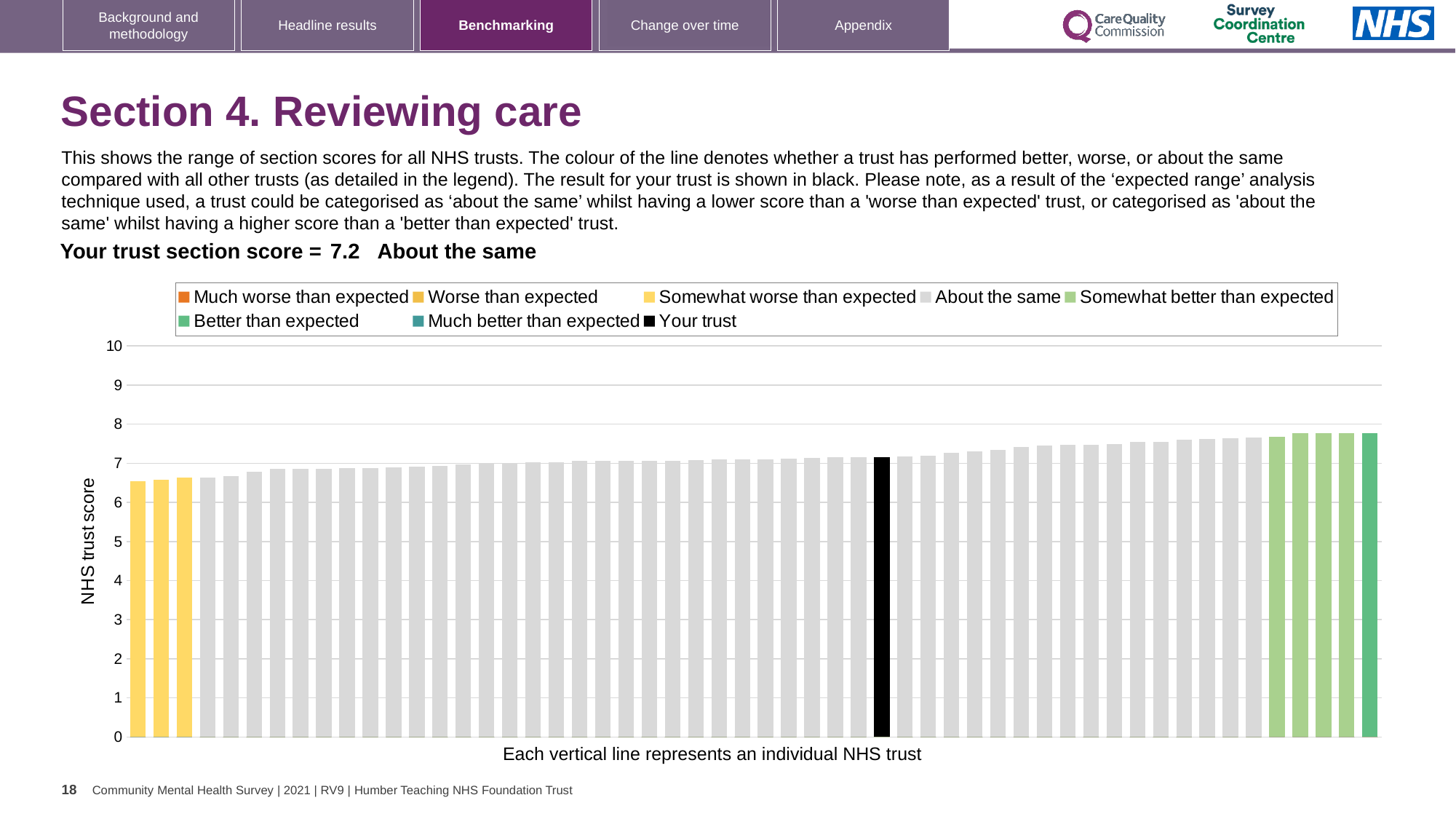
What is the label on the vertical axis of the chart? NHS trust score Is the value of the leftmost bar greater or less than 6? greater Which is higher, the black 'Your trust' bar or the leftmost yellow bar? Your trust What is the section score for your trust shown on the slide? 7.2 Which legend category does the tallest bar belong to? Better than expected Is the value of the black 'Your trust' bar greater or less than 5? greater How many bars are coloured as 'Somewhat better than expected' (light green)? 4 Do the bar values rise or fall from left to right along the x axis? Rise What kind of chart is shown on the slide? Bar chart How many entries does the chart legend list? 8 Is the value of the tallest bar greater or less than 8? less